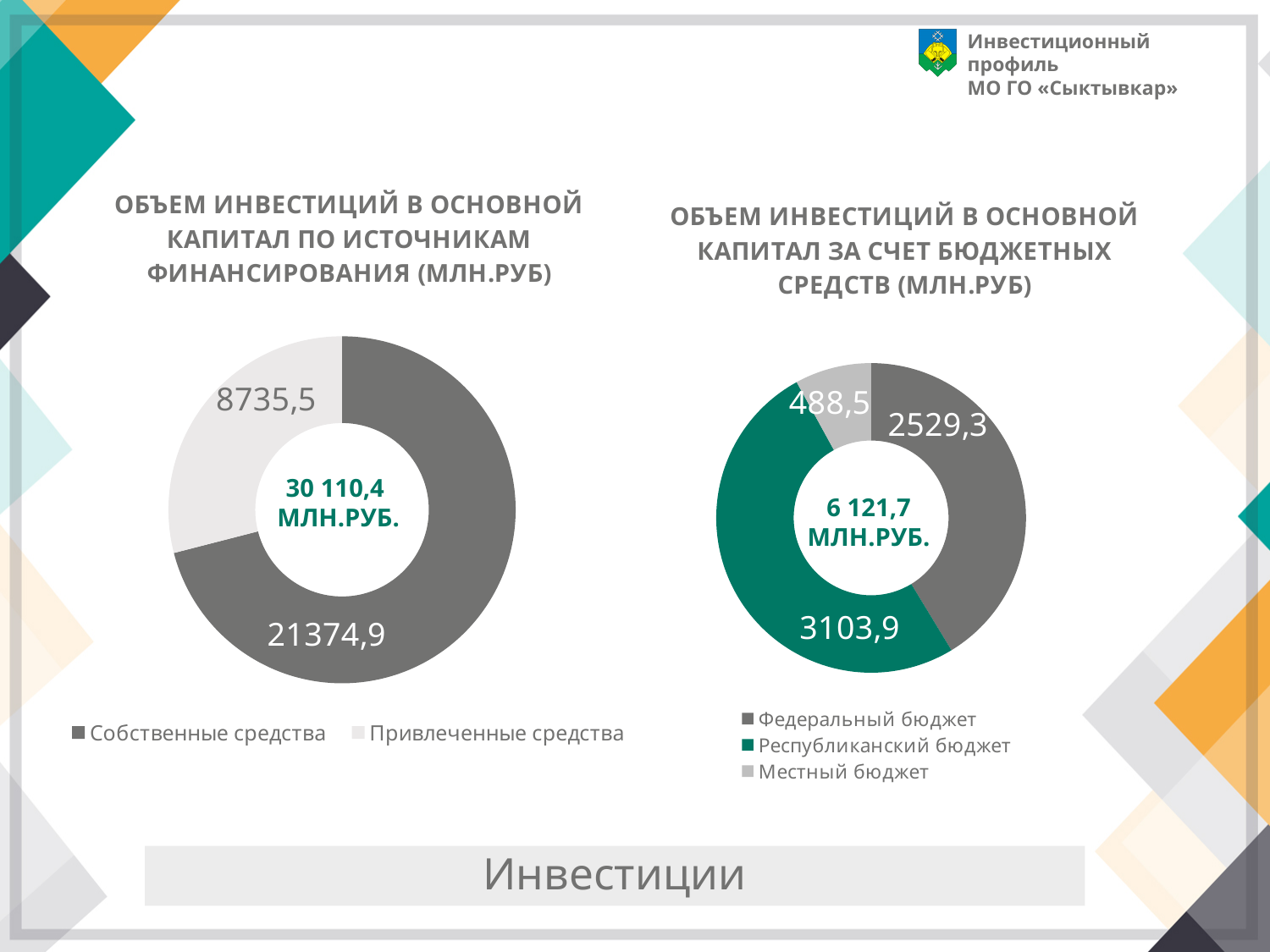
In the right chart, what is the difference between Федеральный бюджет and Местный бюджет? 2040,8 In the right chart, which budget source has the highest value? Республиканский бюджет In the left chart (investment by source of financing), what is the value for Собственные средства? 21374,9 What type of chart is used on the left side of the slide? Doughnut (pie) chart In the right chart, which budget source has the lowest value? Местный бюджет In the left chart, what total is shown in the centre of the doughnut? 30 110,4 млн.руб. How many categories does the legend of the right chart list? 3 In the right chart (investment from budget funds), what is the value for Республиканский бюджет? 3103,9 In the left chart (investment by source of financing), what is the value for Привлеченные средства? 8735,5 In the left chart, what is the difference between Собственные средства and Привлеченные средства? 12639,4 In the left chart, which is larger: Собственные средства or Привлеченные средства? Собственные средства In the right chart (investment from budget funds), what is the value for Местный бюджет? 488,5